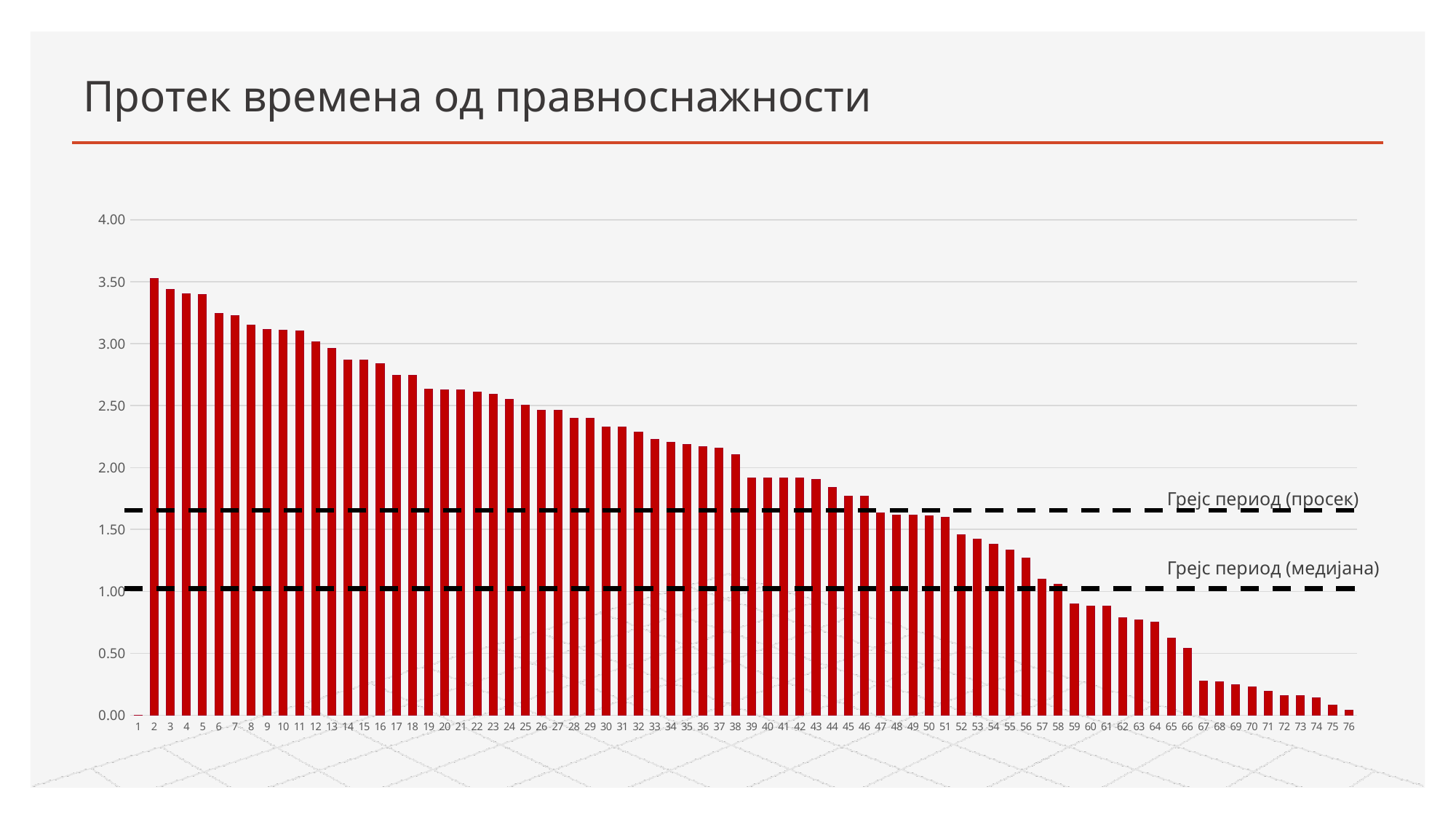
Is the value for category 66 greater or less than 1.00? less What are the labels of the two dashed horizontal lines on the chart? Грејс период (просек) and Грејс период (медијана) Is the value for category 20 greater or less than 2.50? greater What is the title of the chart on the slide? Протек времена од правноснажности Which has the larger value, category 60 or category 20? category 20 Is the value for category 2 greater or less than 3.00? greater What kind of chart is shown on the slide? bar chart How many categories are shown along the x axis of the chart? 76 Which has the larger value, category 5 or category 50? category 5 Which category has the tallest bar in the chart? 2 Do the bar values rise or fall as you move from left to right along the x axis? fall